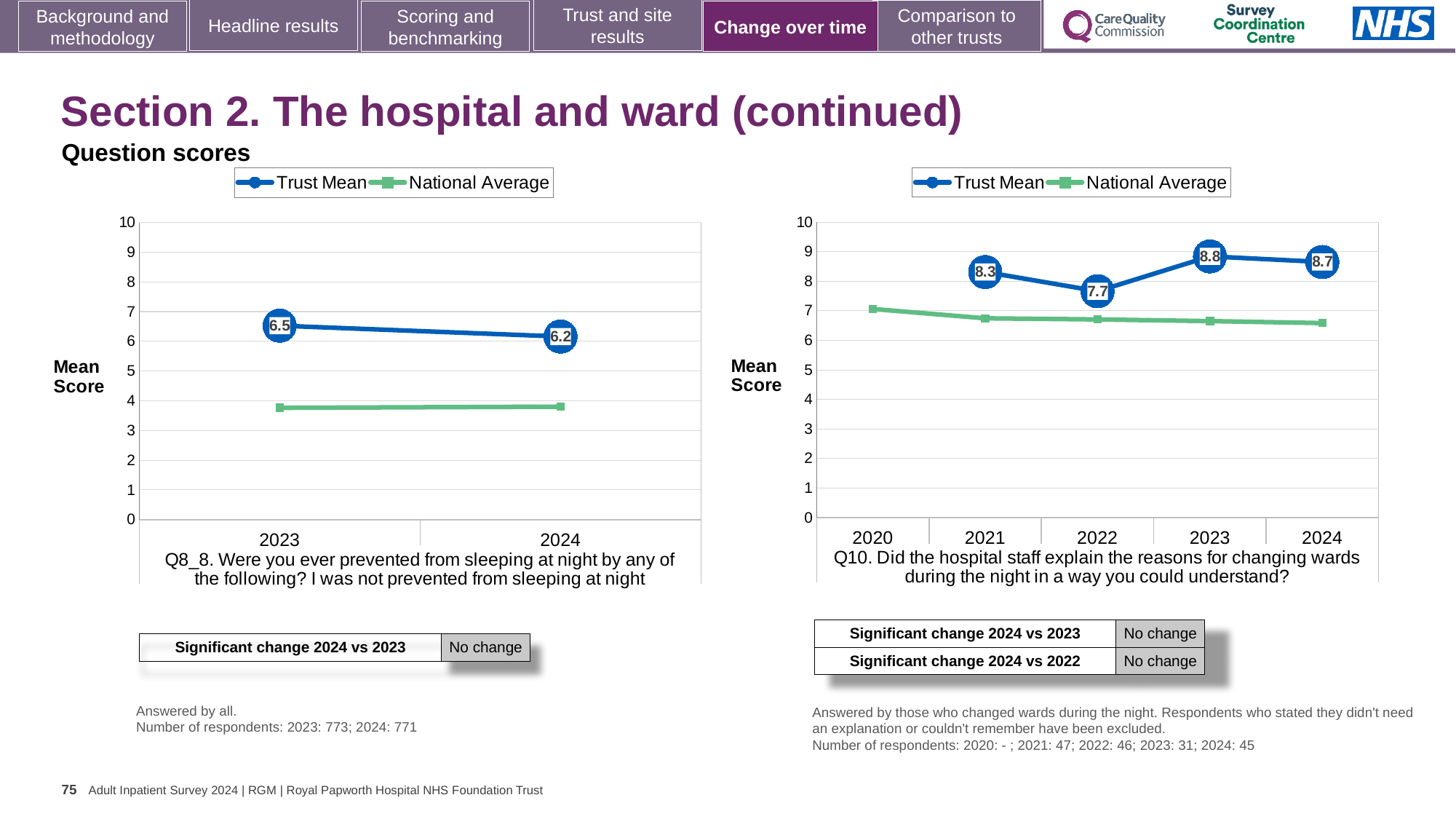
In the left chart (Q8_8), what is the Trust Mean score for 2023? 6.5 In the left chart (Q8_8), does the Trust Mean rise or fall from 2023 to 2024? fall In the right chart (Q10), how many years are shown on the x axis? 5 In the right chart (Q10), is the Trust Mean for 2021 larger or smaller than the Trust Mean for 2024? smaller In the left chart (Q8_8), by how much did the Trust Mean change from 2023 to 2024? 0.3 In the right chart (Q10), which year has the lowest Trust Mean score? 2022 In the right chart (Q10), what is the Trust Mean score for 2022? 7.7 In the left chart (Q8_8), is the National Average value for 2024 greater or less than 4? less How many series does the legend of the right chart (Q10) list? 2 In the right chart (Q10), which year has the highest Trust Mean score? 2023 In the left chart (Q8_8), what is the Trust Mean score for 2024? 6.2 In the right chart (Q10), what is the difference between the Trust Mean scores for 2023 and 2022? 1.1